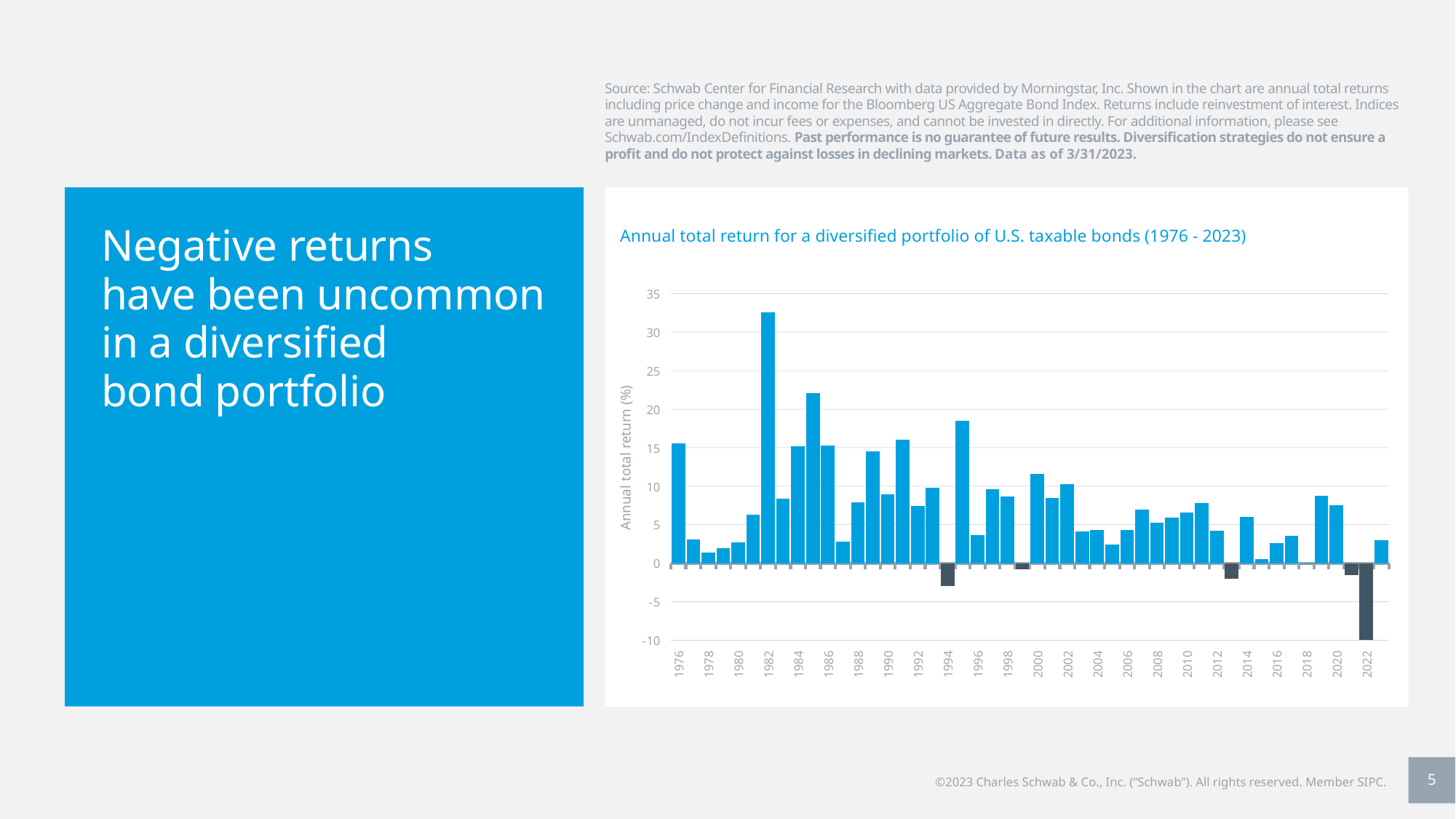
Is the value for 1995 greater or less than 15? greater Which year has the larger annual total return, 2000 or 2001? 2000 What is the label on the vertical axis of the chart? Annual total return (%) Is the value for 1982 greater or less than 30? greater Which year has the lowest annual total return in the chart? 2022 Which year has the larger annual total return, 1982 or 1985? 1982 What is the title of the chart? Annual total return for a diversified portfolio of U.S. taxable bonds (1976 - 2023) What kind of chart is shown on the slide? Bar chart Which year has the highest annual total return in the chart? 1982 Is the value for 1994 greater or less than 0? less